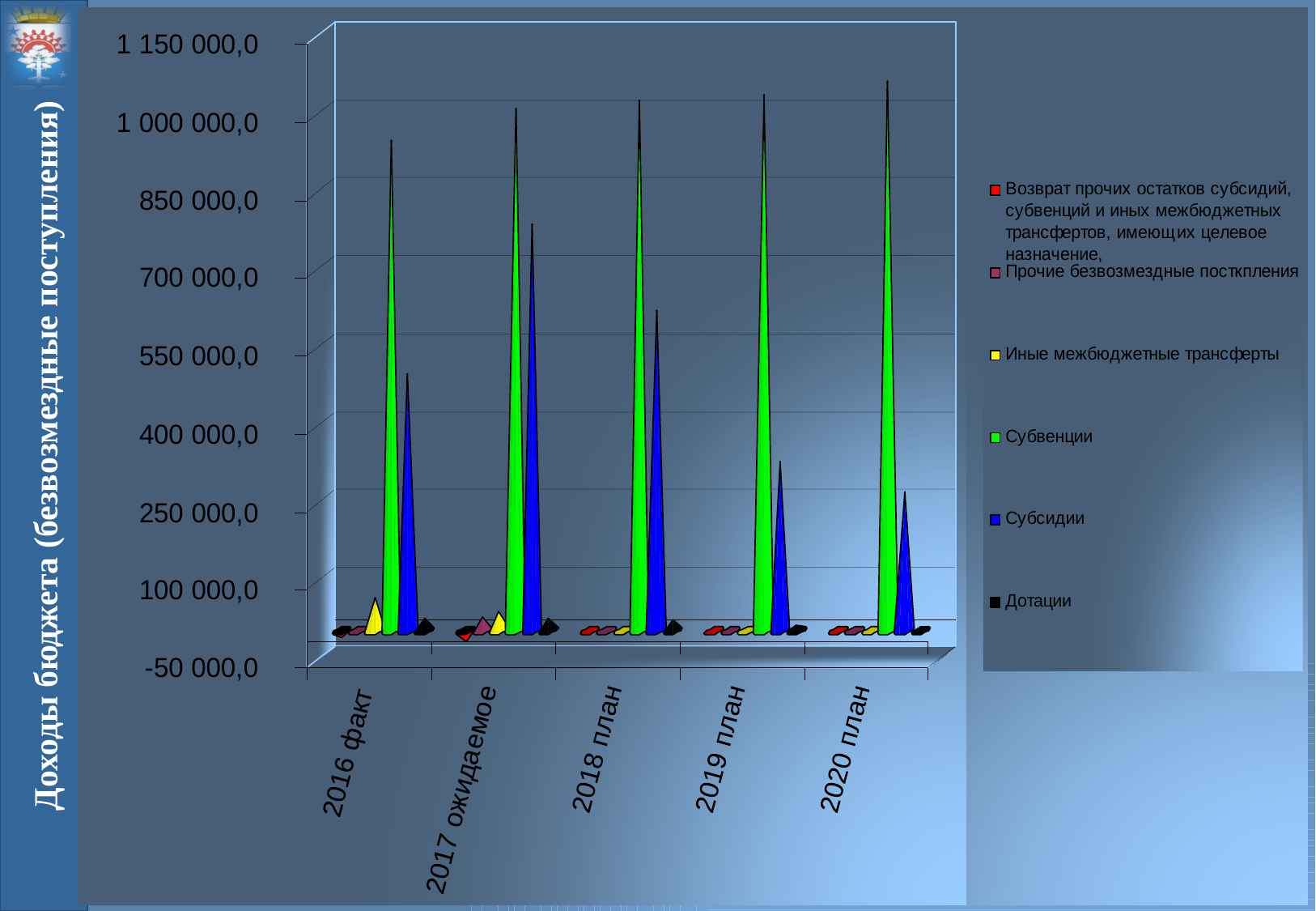
Is the value for Субсидии in 2017 ожидаемое greater or less than 700 000,0? greater Is the value for Субсидии in 2020 план greater or less than 400 000,0? less Do the values for Субвенции rise or fall from 2016 факт to 2020 план? rise What kind of chart is shown on the slide? bar chart Which category has the lowest value for Субсидии? 2020 план How many categories are shown on the x axis of the chart? 5 Which category has the highest value for Субсидии? 2017 ожидаемое Which category has the highest value for Субвенции? 2020 план What colour represents Субвенции in the chart? green How many series does the chart legend list? 6 Which category has the lowest value for Субвенции? 2016 факт Is the value for Субвенции in 2016 факт greater or less than 1 000 000,0? less